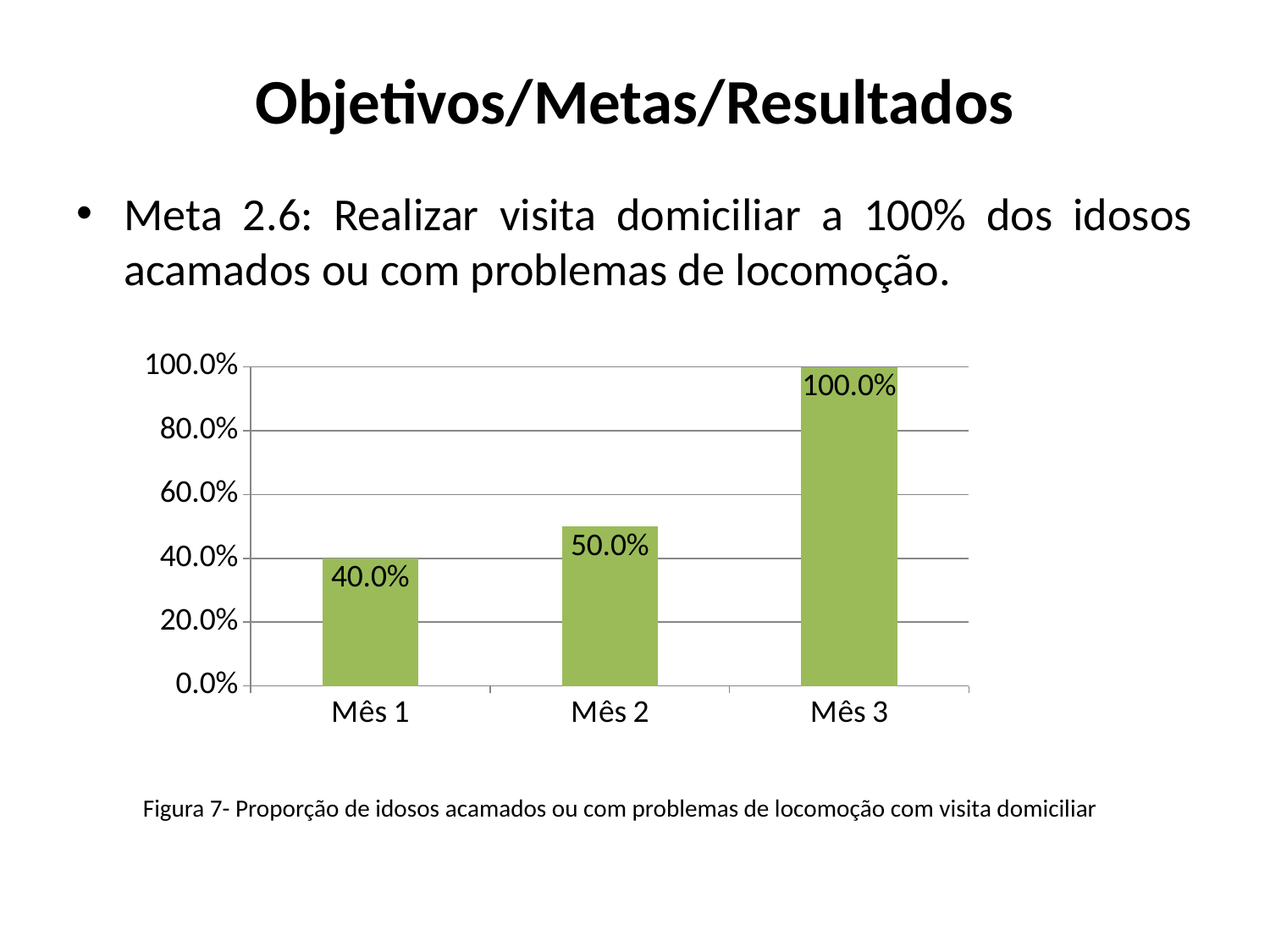
Which month has the lowest value? Mês 1 What is the difference between the values for Mês 3 and Mês 1? 60.0% Which is larger, the value for Mês 2 or the value for Mês 1? Mês 2 Is the value for Mês 2 greater or less than 60.0%? less Which month has the highest value? Mês 3 What is the value for Mês 3? 100.0% What is the value for Mês 2? 50.0% What is the difference between the values for Mês 2 and Mês 1? 10.0% What kind of chart is shown on the slide? bar chart What is the value for Mês 1? 40.0% How many months are shown on the x axis? 3 Do the values rise or fall from Mês 1 to Mês 3? rise